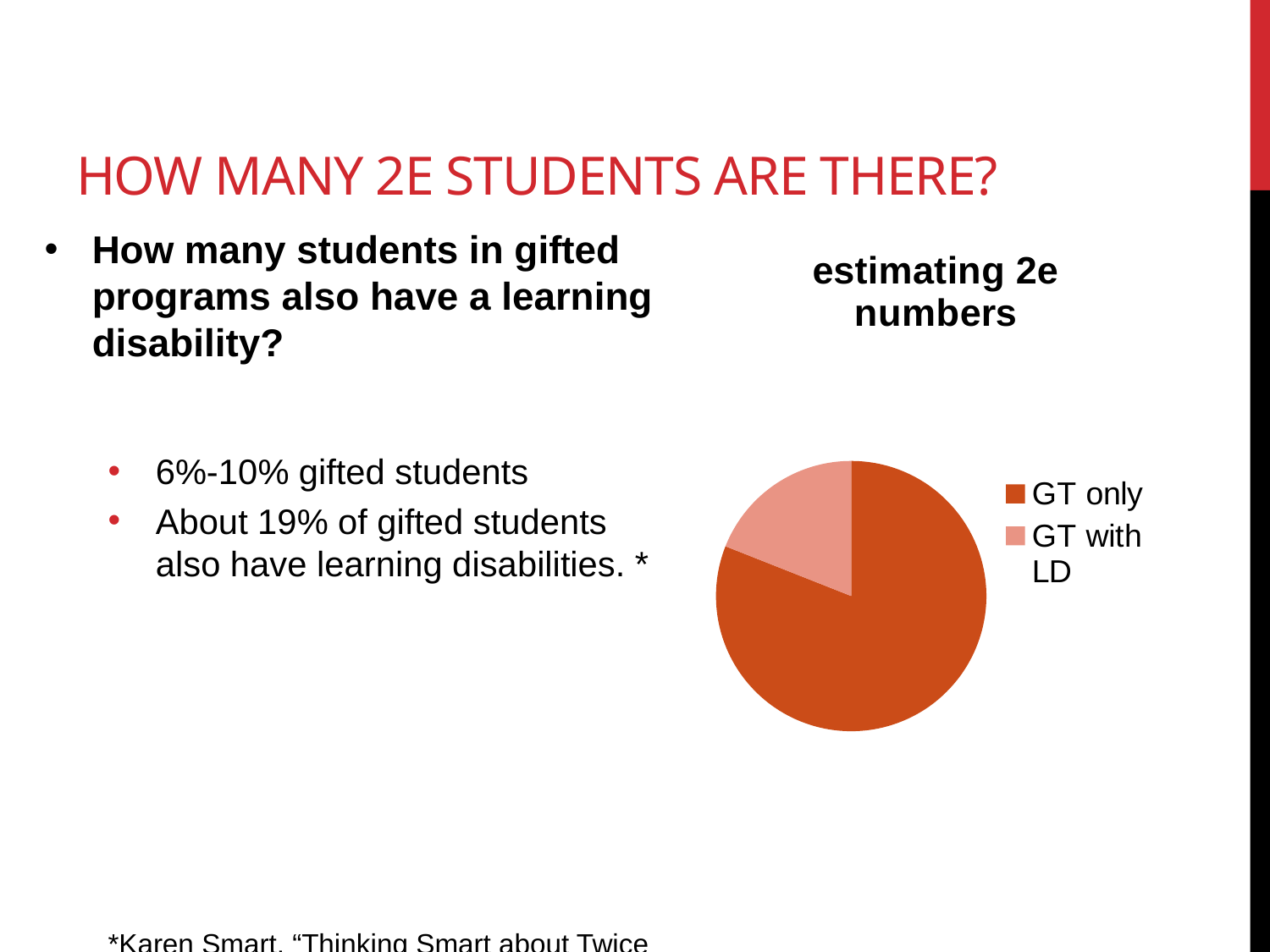
What is the title of the pie chart? estimating 2e numbers Which legend entry in the pie chart is shown in the lighter shade? GT with LD Which slice of the pie chart is the largest? GT only In the pie chart, which is larger: GT only or GT with LD? GT only How many entries does the legend of the pie chart list? 2 Which slice of the pie chart is the smallest? GT with LD What kind of chart is shown on the slide? pie chart How many slices does the pie chart have? 2